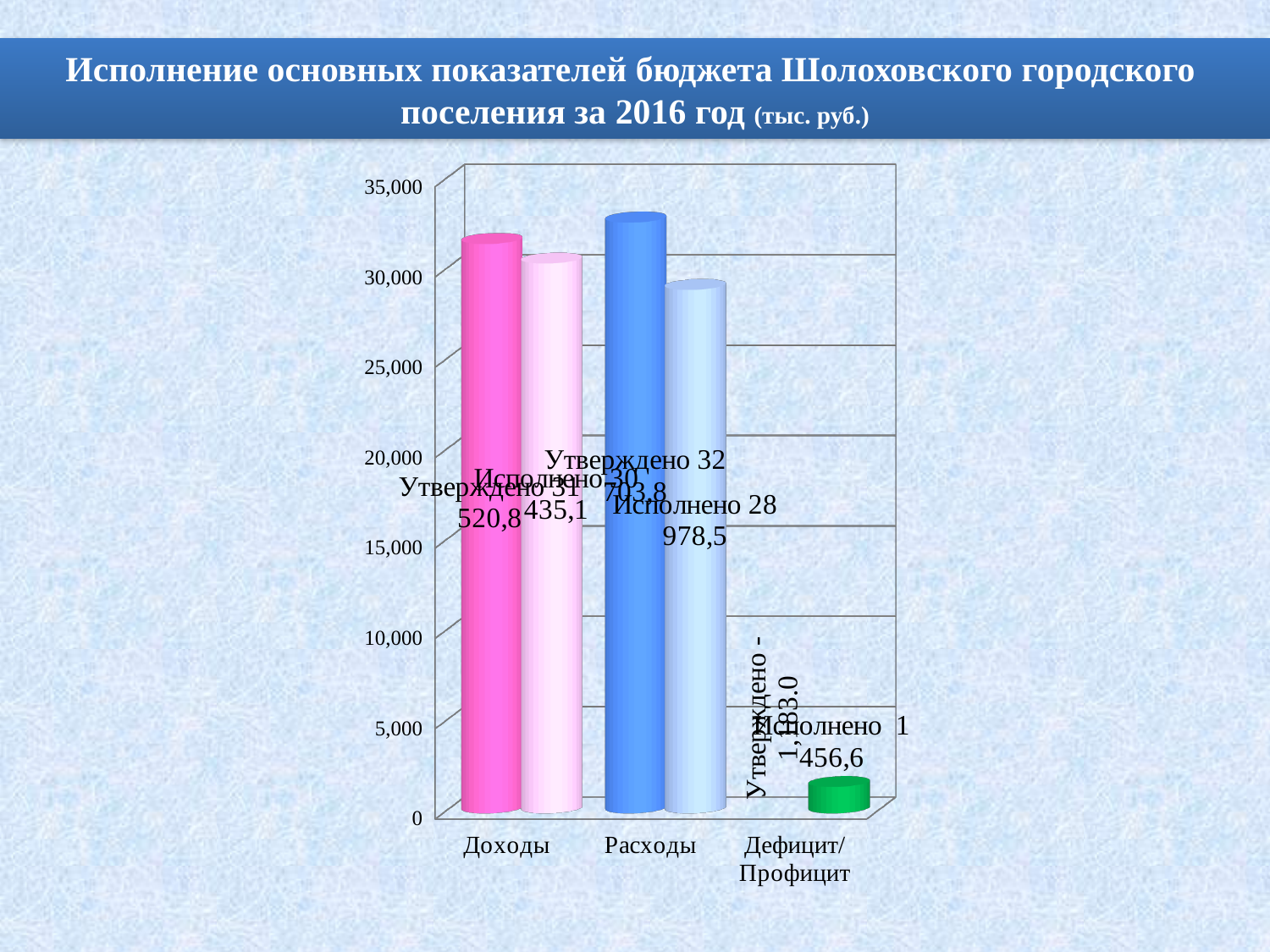
What is the difference between the approved and executed values for Доходы? 1 085,7 What is the approved (Утверждено) value for Доходы? 31 520,8 What is the executed (Исполнено) value for Дефицит/Профицит? 1 456,6 How many categories are shown on the x axis of the chart? 3 What is the executed (Исполнено) value for Расходы? 28 978,5 Is the executed (Исполнено) value for Расходы greater or less than 30,000? less What is the difference between the approved and executed values for Расходы? 3 725,3 Which is larger: the executed value for Доходы or the executed value for Расходы? Доходы (30 435,1) What kind of chart is shown on the slide? Bar chart What is the approved (Утверждено) value for Расходы? 32 703,8 What is the executed (Исполнено) value for Доходы? 30 435,1 Which bar on the chart is the tallest? Расходы, Утверждено (32 703,8)